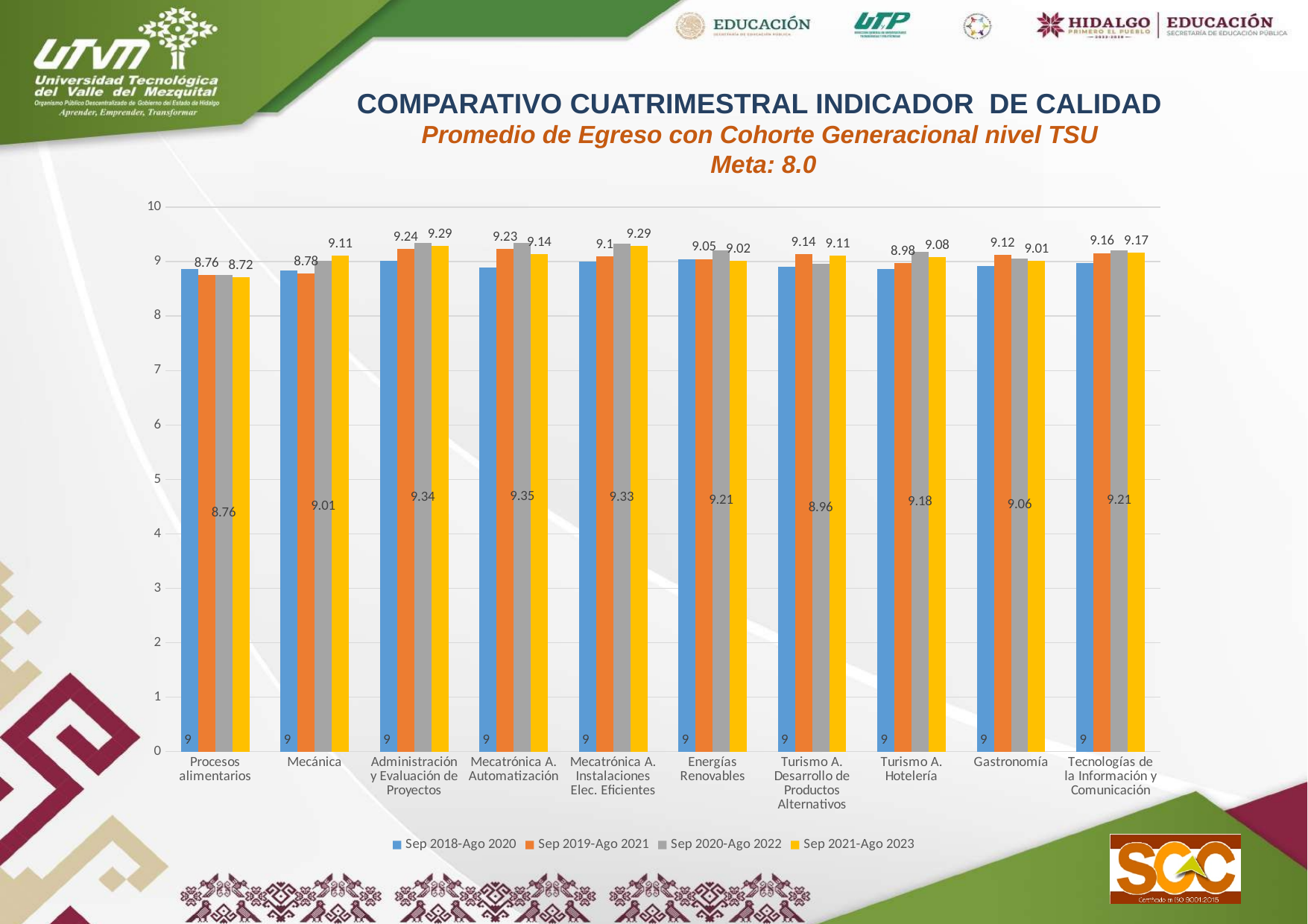
What target (Meta) is stated in the chart title? 8.0 What is the value for Mecánica in the Sep 2021-Ago 2023 series? 9.11 How many series does the legend list? 4 What is the difference between the Sep 2021-Ago 2023 and Sep 2019-Ago 2021 values for Mecánica? 0.33 What is the value for Gastronomía in the Sep 2019-Ago 2021 series? 9.12 For Energías Renovables, which is larger: the Sep 2020-Ago 2022 value or the Sep 2021-Ago 2023 value? Sep 2020-Ago 2022 What kind of chart is shown on the slide? bar chart Is the value for Procesos alimentarios in the Sep 2021-Ago 2023 series greater or less than 8? greater What is the value for Mecatrónica A. Automatización in the Sep 2020-Ago 2022 series? 9.35 How many programs (categories) are shown on the x axis? 10 What is the value for Turismo A. Hotelería in the Sep 2019-Ago 2021 series? 8.98 Which program has the lowest value in the Sep 2021-Ago 2023 series? Procesos alimentarios